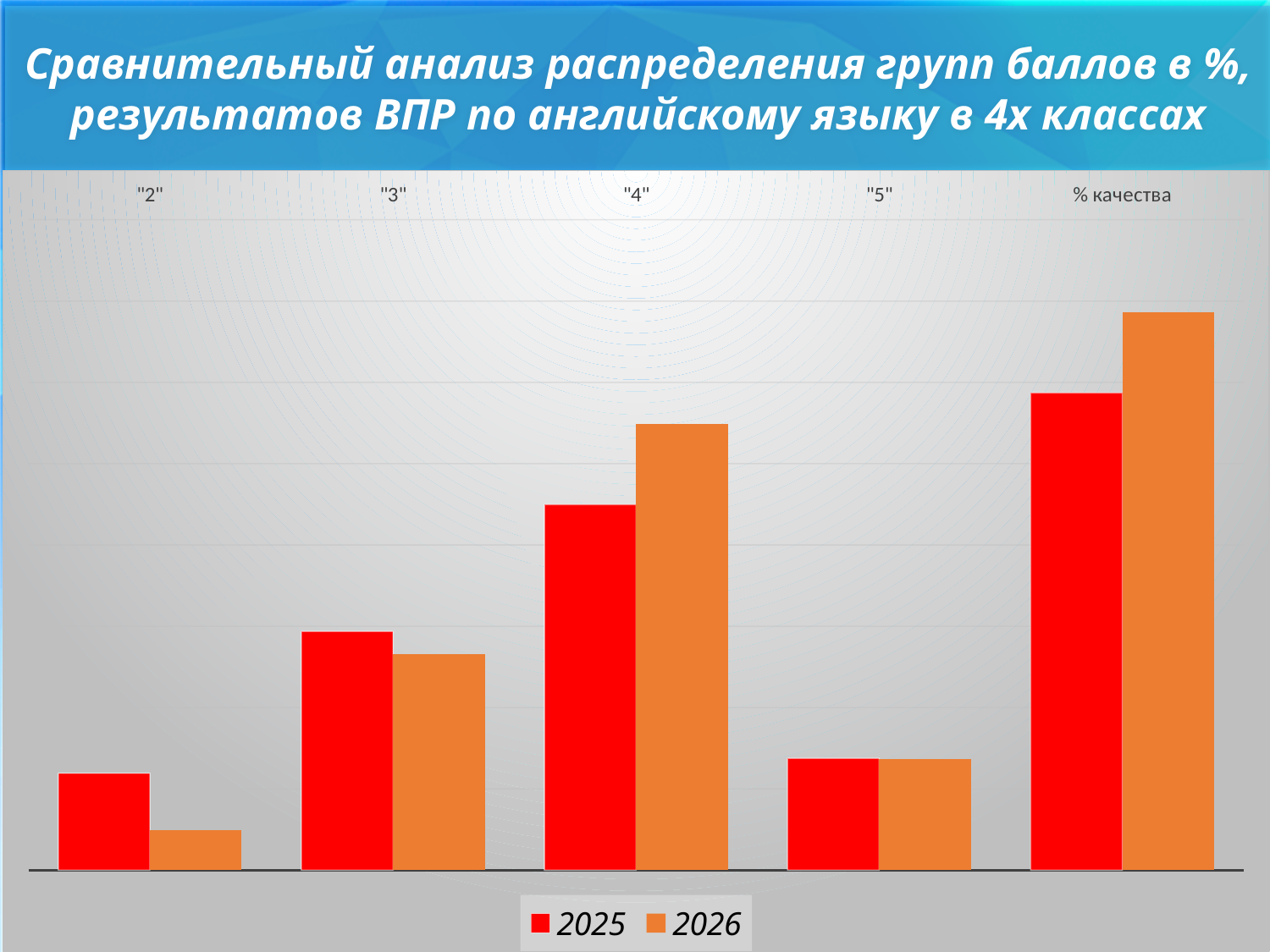
Which series are listed in the chart's legend? 2025 and 2026 Which colour represents the 2026 series in the chart? orange For the 2026 series, which category has the highest bar? % качества For the 2025 series, which category has the lowest bar? "2" What kind of chart is shown on the slide? bar chart How many series does the chart's legend list? 2 For the 2025 series, which category has the highest bar? % качества How many categories are shown along the x axis of the chart? 5 For the 2026 series, which category has the lowest bar? "2" For the category "2", which series has the larger value, 2025 or 2026? 2025 For the category "4", which series has the larger value, 2025 or 2026? 2026 For the category % качества, which series has the larger value, 2025 or 2026? 2026